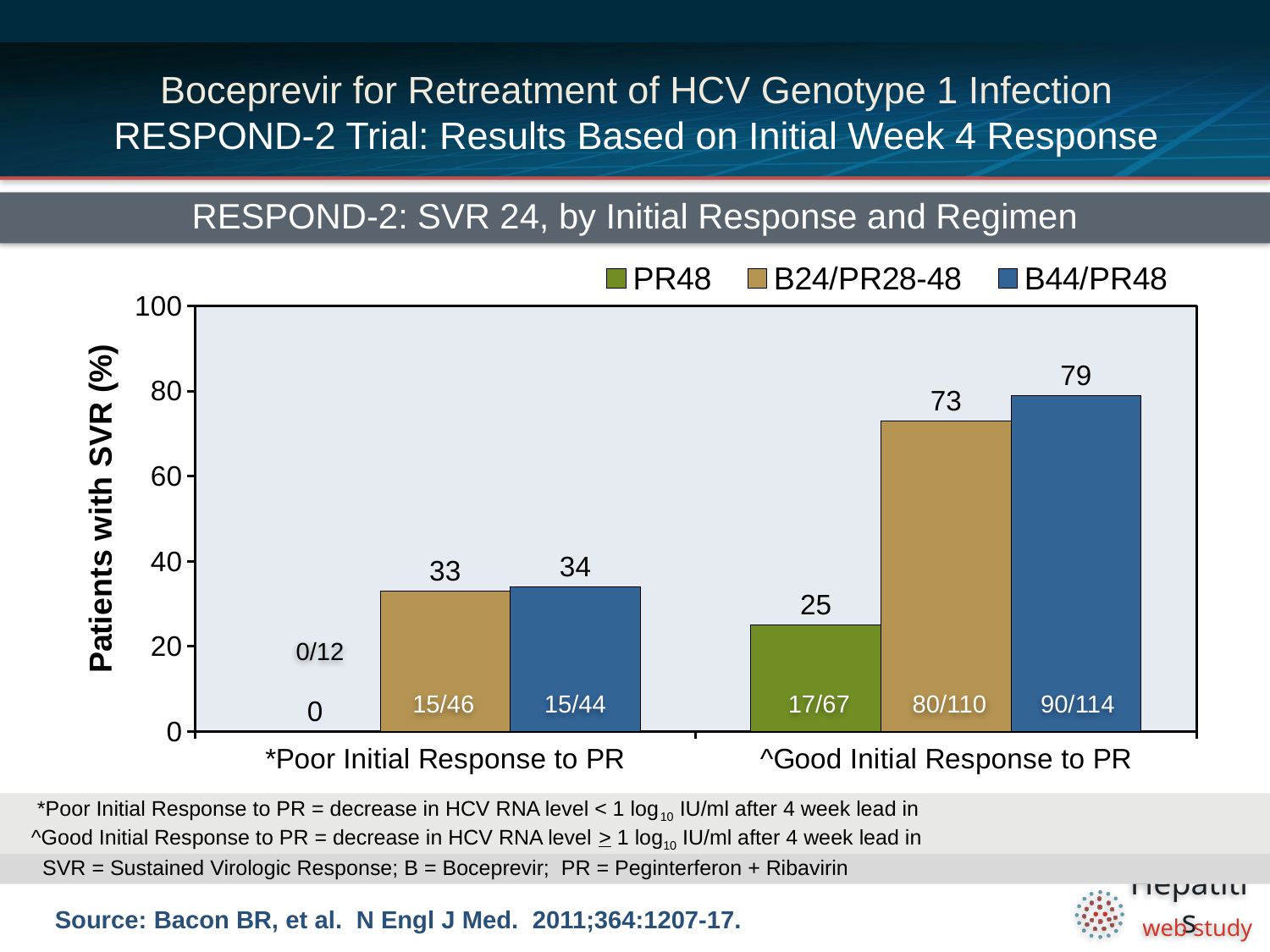
What type of chart is shown on the slide? Bar chart Which regimen has the lowest SVR rate among patients with a poor initial response to PR? PR48 Is the SVR rate for PR48 in the good initial response group greater or less than 40? less What is the SVR rate for B24/PR28-48 among patients with a good initial response to PR? 73 What fraction of patients is shown for the B44/PR48 bar in the poor initial response group? 15/44 How many series does the legend list? 3 What is the difference in SVR rate between B44/PR48 and PR48 in the good initial response group? 54 What is the SVR rate for PR48 among patients with a poor initial response to PR? 0 What is the label of the y axis? Patients with SVR (%) Which is larger: the SVR rate for B24/PR28-48 in the good initial response group or in the poor initial response group? Good initial response group What is the SVR rate for B44/PR48 among patients with a good initial response to PR? 79 Which regimen has the highest SVR rate among patients with a good initial response to PR? B44/PR48